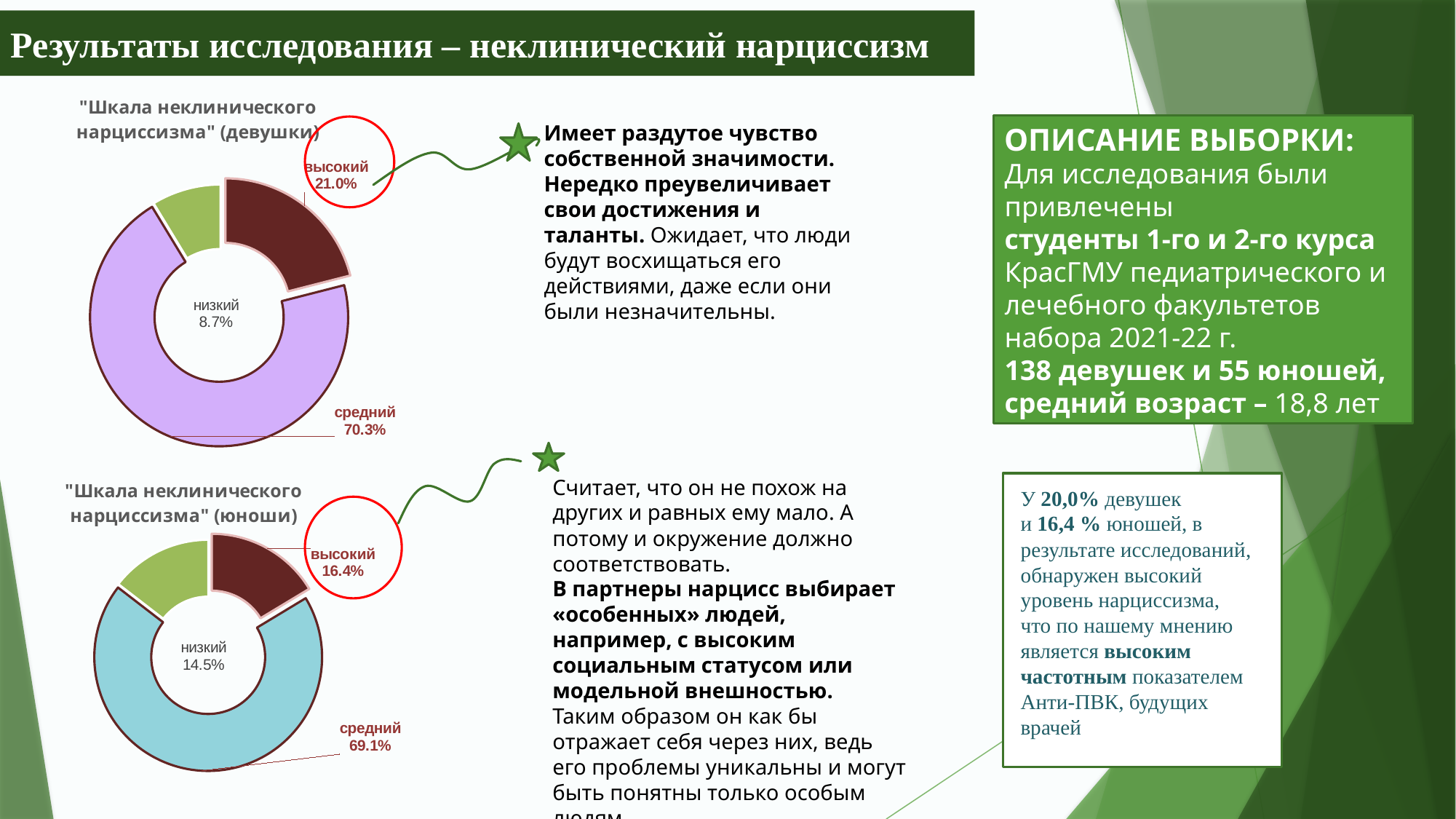
Сколько категорий (уровней) показано на диаграмме «Шкала неклинического нарциссизма» (юноши)? 3 На диаграмме «Шкала неклинического нарциссизма» (девушки) какой уровень имеет наибольшую долю? средний На диаграмме «Шкала неклинического нарциссизма» (девушки) какой уровень имеет наименьшую долю? низкий На диаграмме «Шкала неклинического нарциссизма» (девушки) какая доля приходится на уровень «средний»? 70.3% На диаграмме «Шкала неклинического нарциссизма» (юноши) какой уровень имеет наибольшую долю? средний Какая доля уровня «высокий» больше: у девушек (верхняя диаграмма) или у юношей (нижняя диаграмма)? у девушек На диаграмме «Шкала неклинического нарциссизма» (юноши) какая доля приходится на уровень «высокий»? 16.4% На диаграмме «Шкала неклинического нарциссизма» (девушки) какая доля приходится на уровень «высокий»? 21.0% На диаграмме «Шкала неклинического нарциссизма» (юноши) на сколько процентных пунктов доля «средний» больше доли «высокий»? 52.7 На диаграмме «Шкала неклинического нарциссизма» (юноши) какая доля приходится на уровень «низкий»? 14.5% Какого типа диаграмма «Шкала неклинического нарциссизма» (девушки)? кольцевая (круговая) диаграмма На диаграмме «Шкала неклинического нарциссизма» (девушки) на сколько процентных пунктов доля «высокий» больше доли «низкий»? 12.3